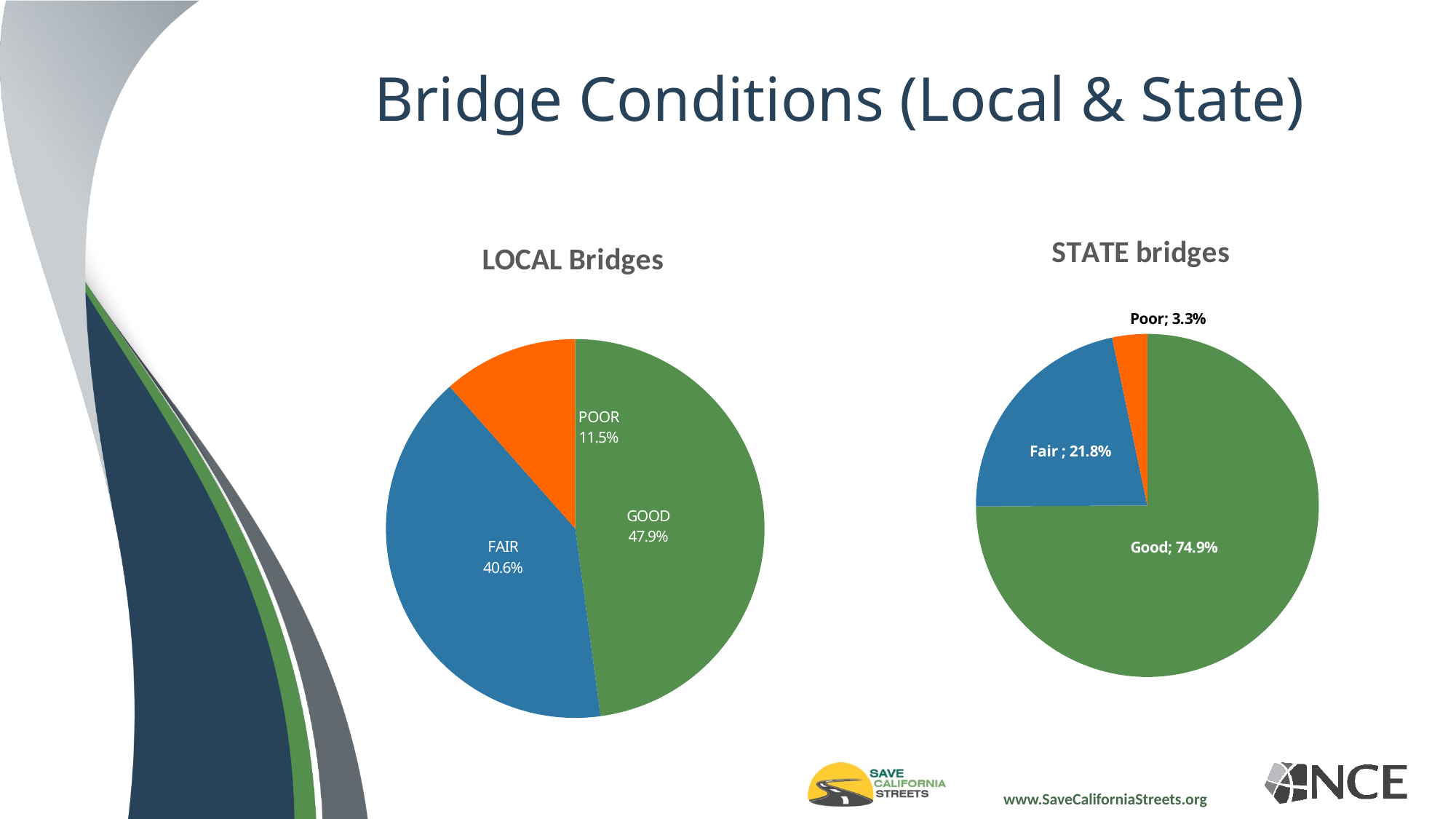
How many condition categories does the STATE bridges chart show? 3 In the LOCAL Bridges chart, which condition category has the smallest slice? POOR In the STATE bridges chart, what colour is the Fair slice? Blue In the LOCAL Bridges chart, what share of bridges is in GOOD condition? 47.9% In the LOCAL Bridges chart, what share of bridges is in FAIR condition? 40.6% What type of chart is the LOCAL Bridges chart? Pie chart In the STATE bridges chart, what share of bridges is in Poor condition? 3.3% In the STATE bridges chart, which condition category has the largest slice? Good Which chart shows a larger share of bridges in Poor condition, LOCAL Bridges or STATE bridges? LOCAL Bridges In the LOCAL Bridges chart, what is the difference between the GOOD and FAIR shares? 7.3% In the LOCAL Bridges chart, what share of bridges is in POOR condition? 11.5% In the STATE bridges chart, what share of bridges is in Good condition? 74.9%